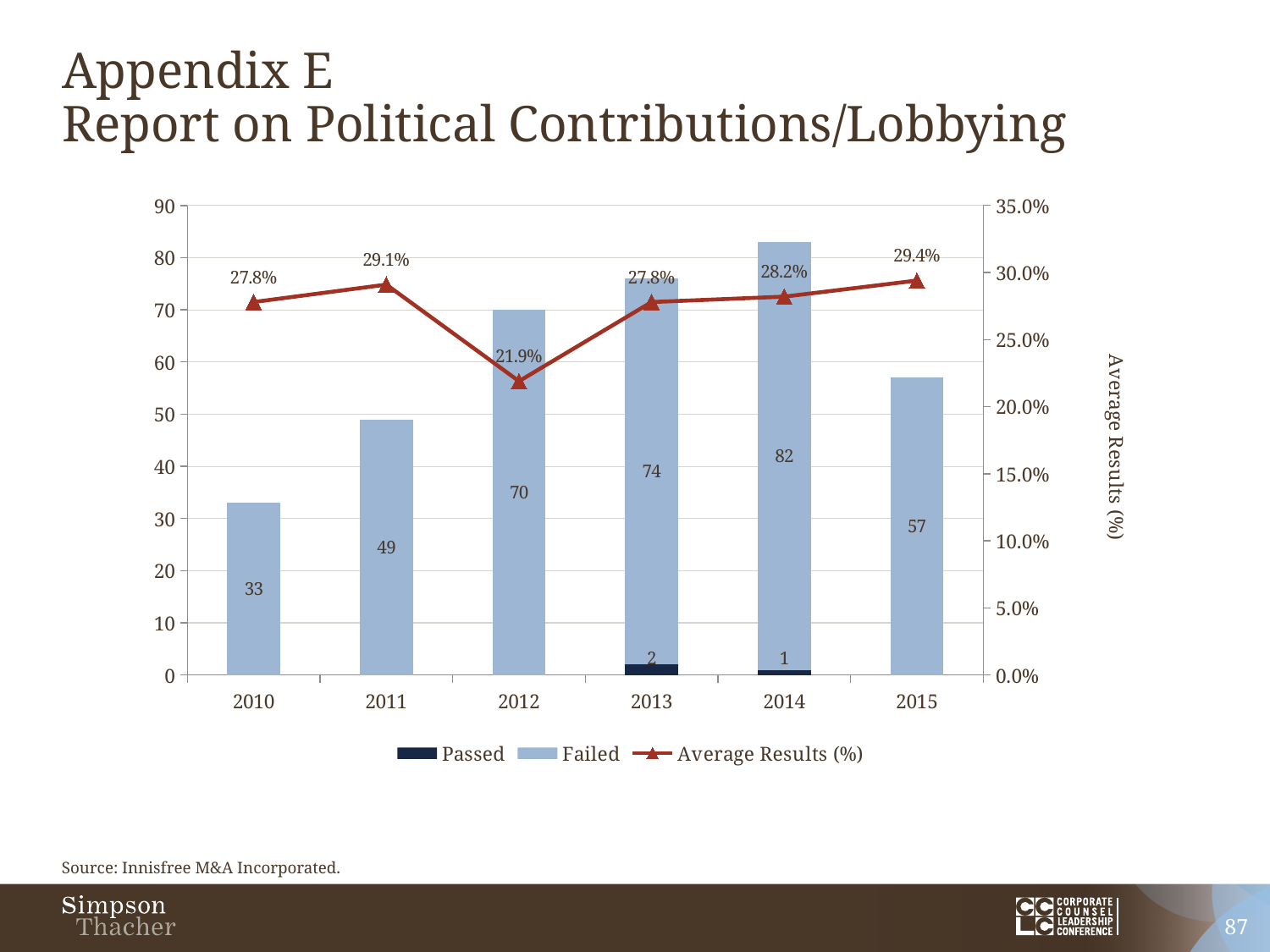
Which year has the highest Failed value? 2014 Which year has the lowest Average Results (%) value? 2012 What is the label of the right-hand vertical axis? Average Results (%) What kind of chart is shown on the slide? A stacked bar chart with a line series What is the Average Results (%) value for 2012? 21.9% What is the total of the stacked bar for 2014 (Passed plus Failed)? 83 What is the difference between the Failed values for 2012 and 2010? 37 What is the Passed value for 2013? 2 How many series does the legend list? 3 How many years are shown on the x axis? 6 Which is larger, the Failed value for 2011 or the Failed value for 2015? 2015 What is the Failed value for 2014? 82